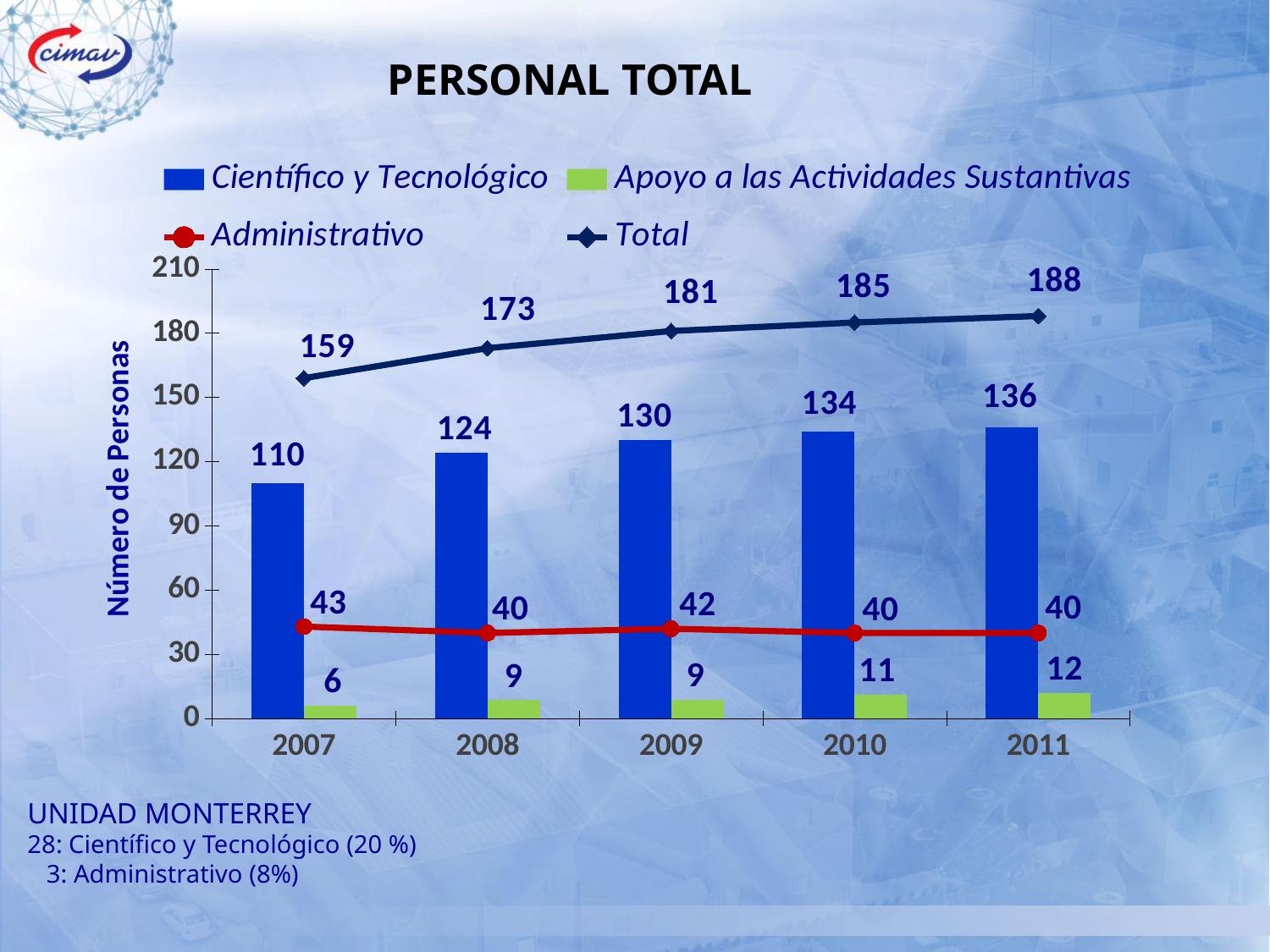
What is the value of Apoyo a las Actividades Sustantivas in 2010? 11 How many years are shown on the x axis? 5 Does the Total rise or fall from 2007 to 2011? rise In which year is the Total highest? 2011 How many series does the legend list? 4 What is the Administrativo value in 2007? 43 What is the value of Científico y Tecnológico in 2009? 130 What is the Total value for 2011? 188 What is the title of the chart? PERSONAL TOTAL In which year is Apoyo a las Actividades Sustantivas lowest? 2007 Which is larger, Científico y Tecnológico in 2008 or in 2010? 2010 What is the difference between the Total in 2011 and the Total in 2007? 29